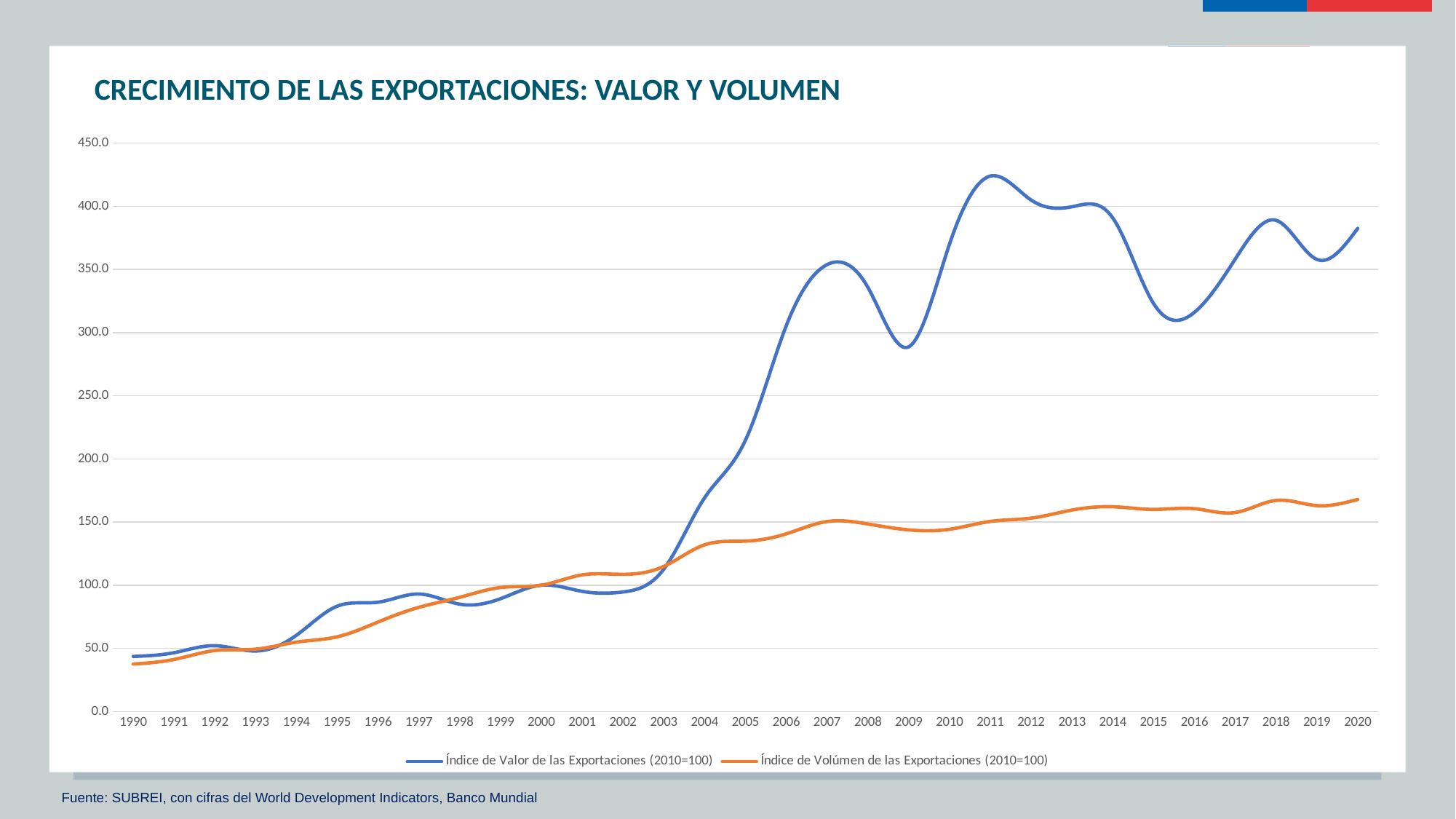
What kind of chart is shown on the slide? line chart How many series does the legend list? 2 Which year has the lowest value for Índice de Volúmen de las Exportaciones (2010=100)? 1990 Which year has the highest value for Índice de Valor de las Exportaciones (2010=100)? 2011 In 2020, which series has the larger value: Índice de Valor de las Exportaciones or Índice de Volúmen de las Exportaciones? Índice de Valor de las Exportaciones (2010=100) Is the value for Índice de Valor de las Exportaciones (2010=100) in 2009 greater or less than 300? less Is the value for Índice de Volúmen de las Exportaciones (2010=100) in 2020 greater or less than 150? greater Does the Índice de Volúmen de las Exportaciones (2010=100) line generally rise or fall from 1990 to 2020? rise Is the value for Índice de Volúmen de las Exportaciones (2010=100) in 2005 greater or less than 150? less How many years are plotted along the x axis? 31 What is the title of the chart? CRECIMIENTO DE LAS EXPORTACIONES: VALOR Y VOLUMEN